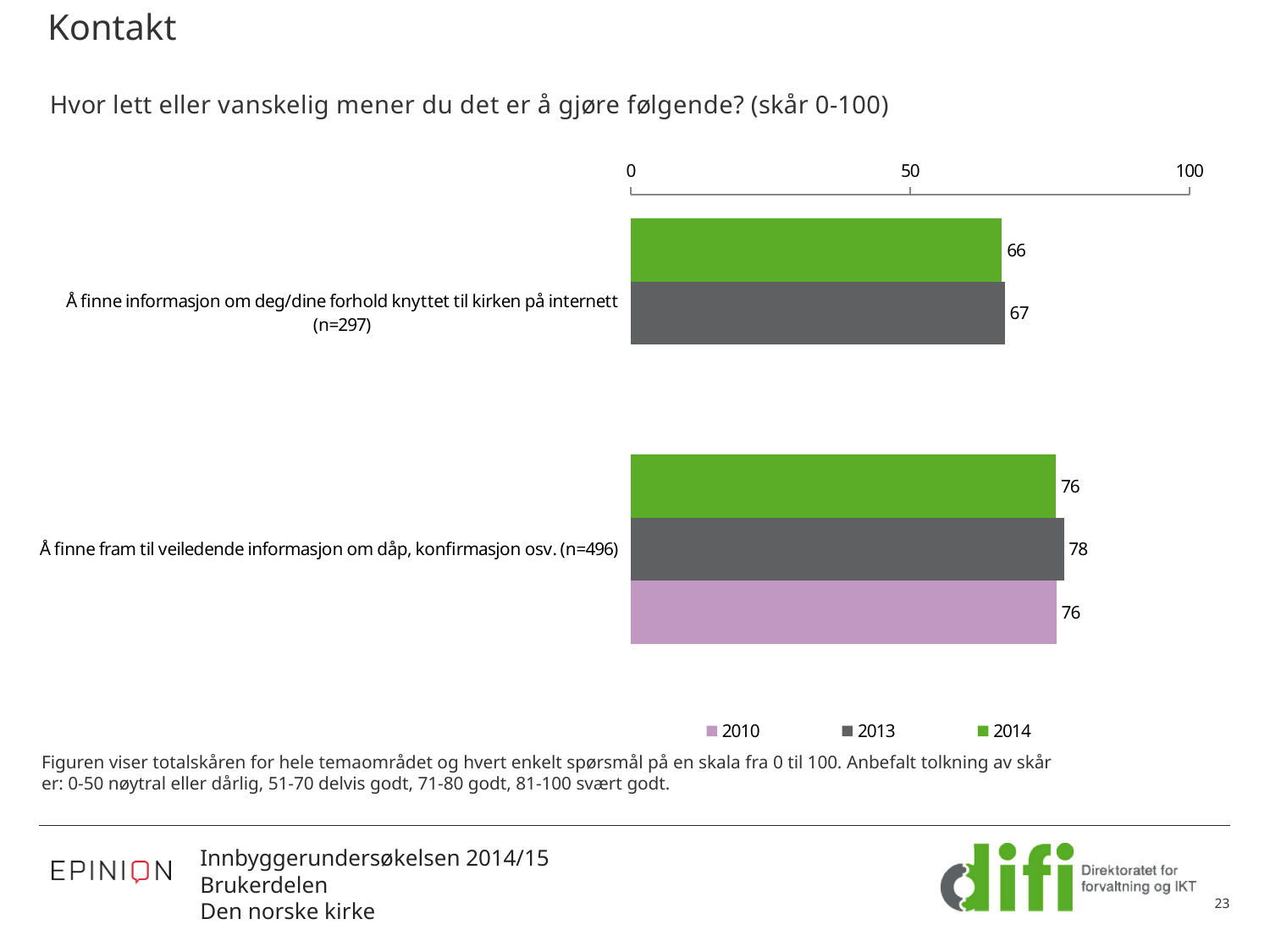
What is the 2013 value for "Å finne fram til veiledende informasjon om dåp, konfirmasjon osv. (n=496)"? 78 What is the difference between the 2014 values of the two categories? 10 Is the 2014 value for "Å finne informasjon om deg/dine forhold knyttet til kirken på internett (n=297)" greater or less than 50? greater What is the 2013 value for "Å finne informasjon om deg/dine forhold knyttet til kirken på internett (n=297)"? 67 What is the difference between the 2013 and 2014 values for "Å finne fram til veiledende informasjon om dåp, konfirmasjon osv. (n=496)"? 2 What kind of chart is shown on the slide? bar chart What is the 2014 value for "Å finne informasjon om deg/dine forhold knyttet til kirken på internett (n=297)"? 66 Which is larger: the 2013 value for "Å finne informasjon om deg/dine forhold knyttet til kirken på internett (n=297)" or the 2013 value for "Å finne fram til veiledende informasjon om dåp, konfirmasjon osv. (n=496)"? Å finne fram til veiledende informasjon om dåp, konfirmasjon osv. (n=496) What is the 2010 value for "Å finne fram til veiledende informasjon om dåp, konfirmasjon osv. (n=496)"? 76 How many categories are shown in the chart? 2 How many series does the legend list? 3 Which category has the highest 2014 value? Å finne fram til veiledende informasjon om dåp, konfirmasjon osv. (n=496)